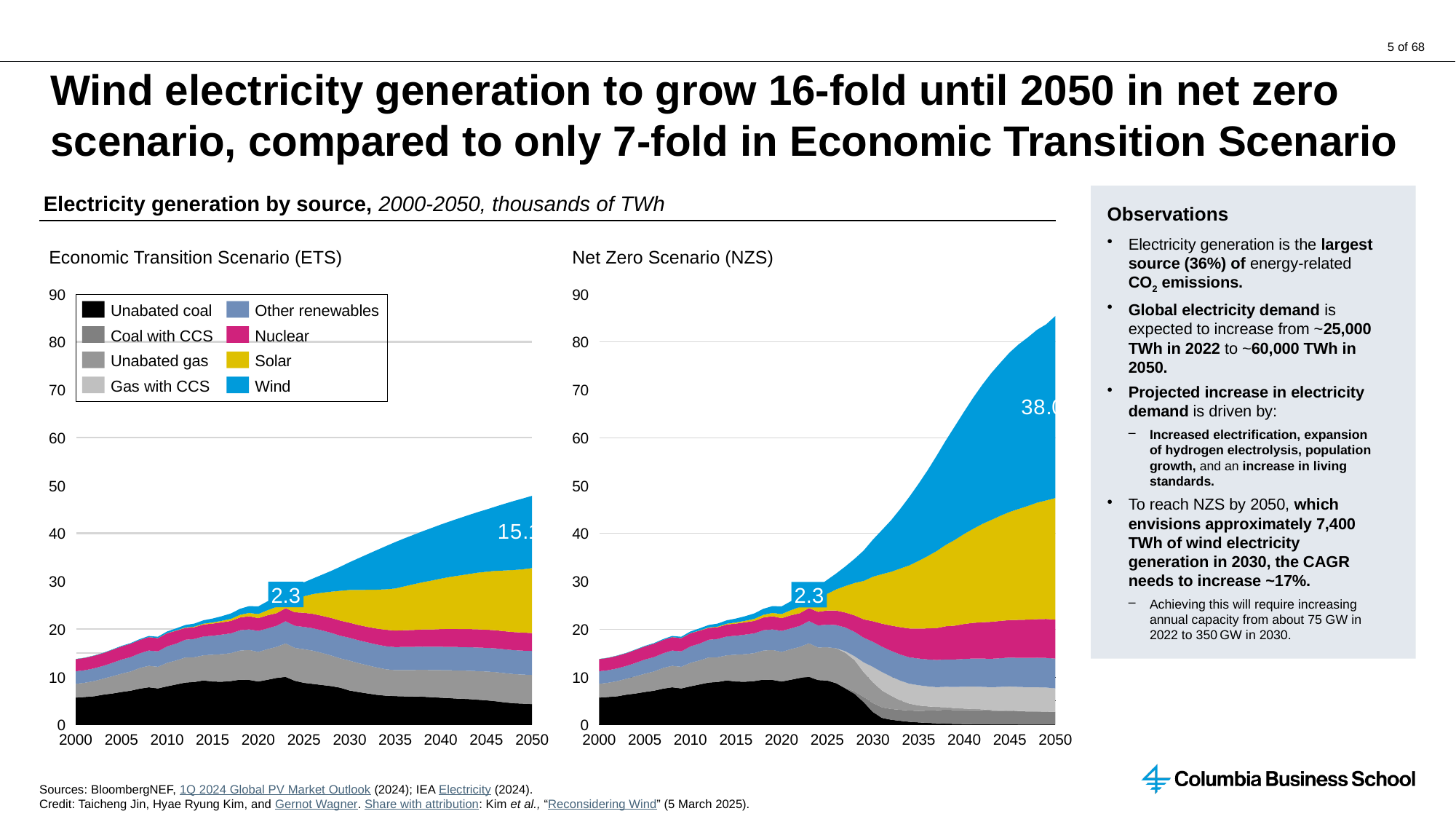
What kind of chart is the Economic Transition Scenario (ETS) chart? Stacked area chart On the Net Zero Scenario (NZS) chart, does total electricity generation rise or fall from 2000 to 2050? Rise On the Net Zero Scenario (NZS) chart, what value is labelled on the Wind series around 2023? 2.3 What is the unit stated in the title above the two charts? thousands of TWh How many series does the legend on the Economic Transition Scenario (ETS) chart list? 8 On the Economic Transition Scenario (ETS) chart, what value is labelled on the Wind series around 2023? 2.3 Which chart shows the larger total electricity generation in 2050, the Economic Transition Scenario (ETS) or the Net Zero Scenario (NZS)? Net Zero Scenario (NZS) On the Net Zero Scenario (NZS) chart, is the total electricity generation in 2050 greater or less than 80? greater What colour represents Wind in the legend of the Economic Transition Scenario (ETS) chart? Blue On the Economic Transition Scenario (ETS) chart, is the total electricity generation in 2050 greater or less than 60? less On the Economic Transition Scenario (ETS) chart, is the total electricity generation in 2050 greater or less than 40? greater How many year labels are shown on the x axis of the Economic Transition Scenario (ETS) chart? 11